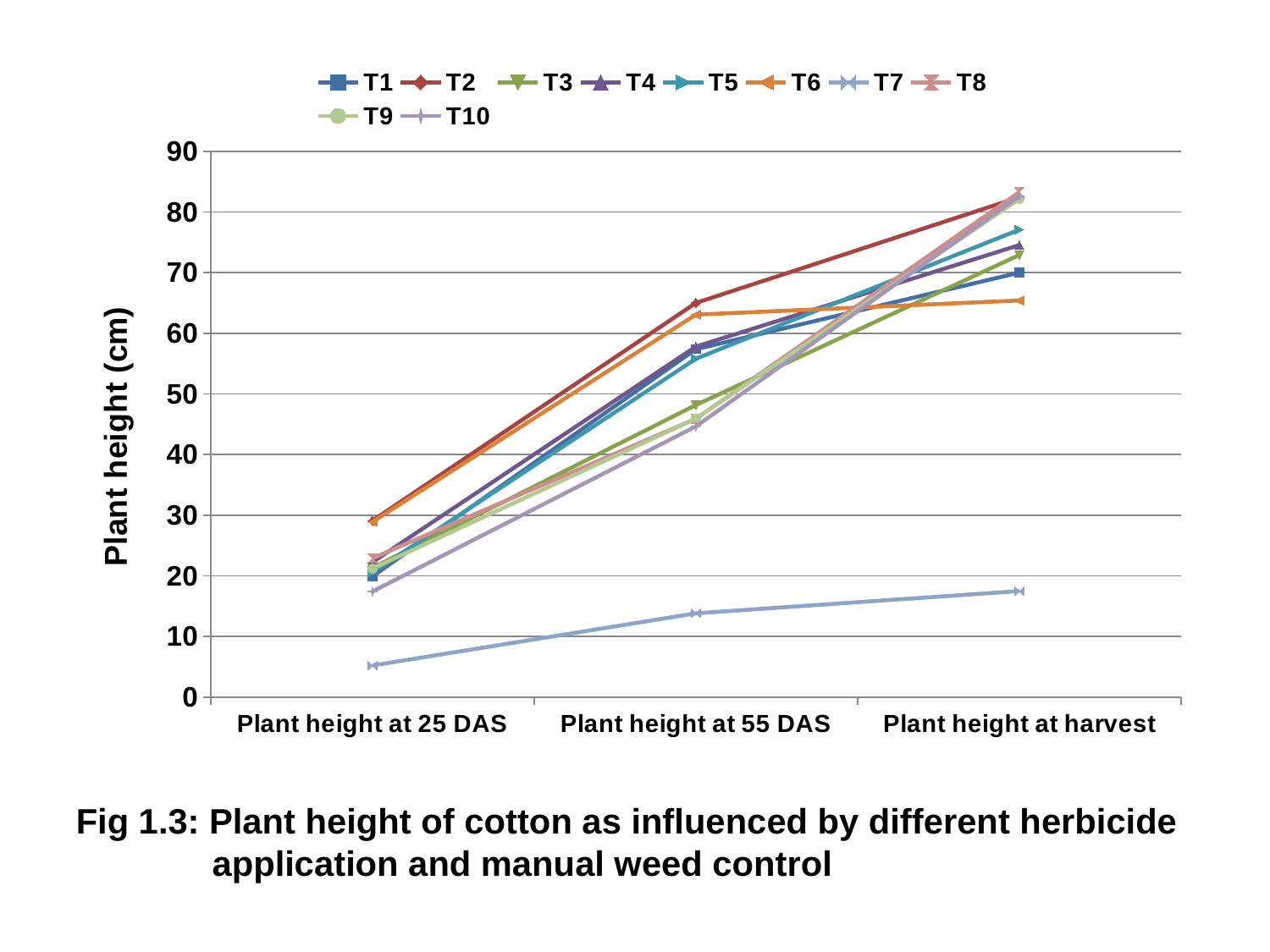
What is the title of the y axis? Plant height (cm) Is the value for T7 at harvest greater or less than 20? less How many categories are shown along the x axis? 3 Is the value for T5 at harvest greater or less than 70? greater What kind of chart is shown on the slide? line chart Is the value for T2 at 55 DAS greater or less than 60? greater Does the plant height for T7 rise or fall from 25 DAS to harvest? rise How many series does the legend list? 10 Which is larger at harvest, the value for T5 or the value for T6? T5 Which series has the lowest plant height at harvest? T7 Which series has the lowest plant height at 25 DAS? T7